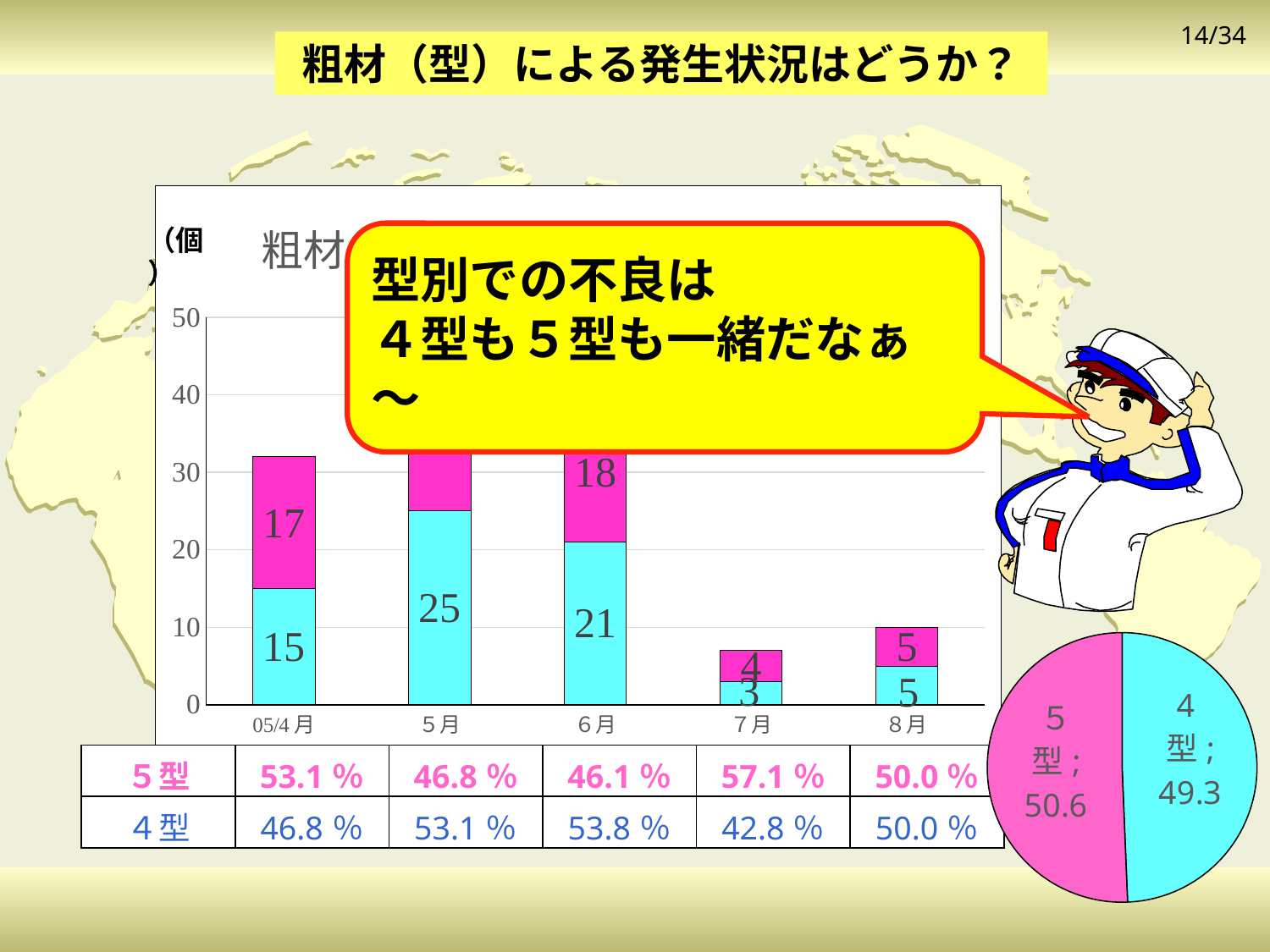
In the stacked bar chart, for 05/4月, which segment is larger, the magenta one or the cyan one? magenta How many months are shown on the x axis of the stacked bar chart? 5 In the stacked bar chart, what is the total of the stacked bar for 7月? 7 In the pie chart at the bottom right, what share is shown for 5型? 50.6 In the stacked bar chart, what is the value of the cyan (bottom) segment for 05/4月? 15 In the stacked bar chart, what is the total of the stacked bar for 05/4月? 32 In the stacked bar chart, what is the difference between the cyan and magenta segments for 6月? 3 In the stacked bar chart, what is the total of the stacked bar for 6月? 39 In the stacked bar chart, which month has the largest cyan (bottom) segment? 5月 In the stacked bar chart, what is the value of the magenta (top) segment for 6月? 18 In the stacked bar chart, which month has the smallest cyan (bottom) segment? 7月 In the stacked bar chart, what is the value of the cyan (bottom) segment for 5月? 25